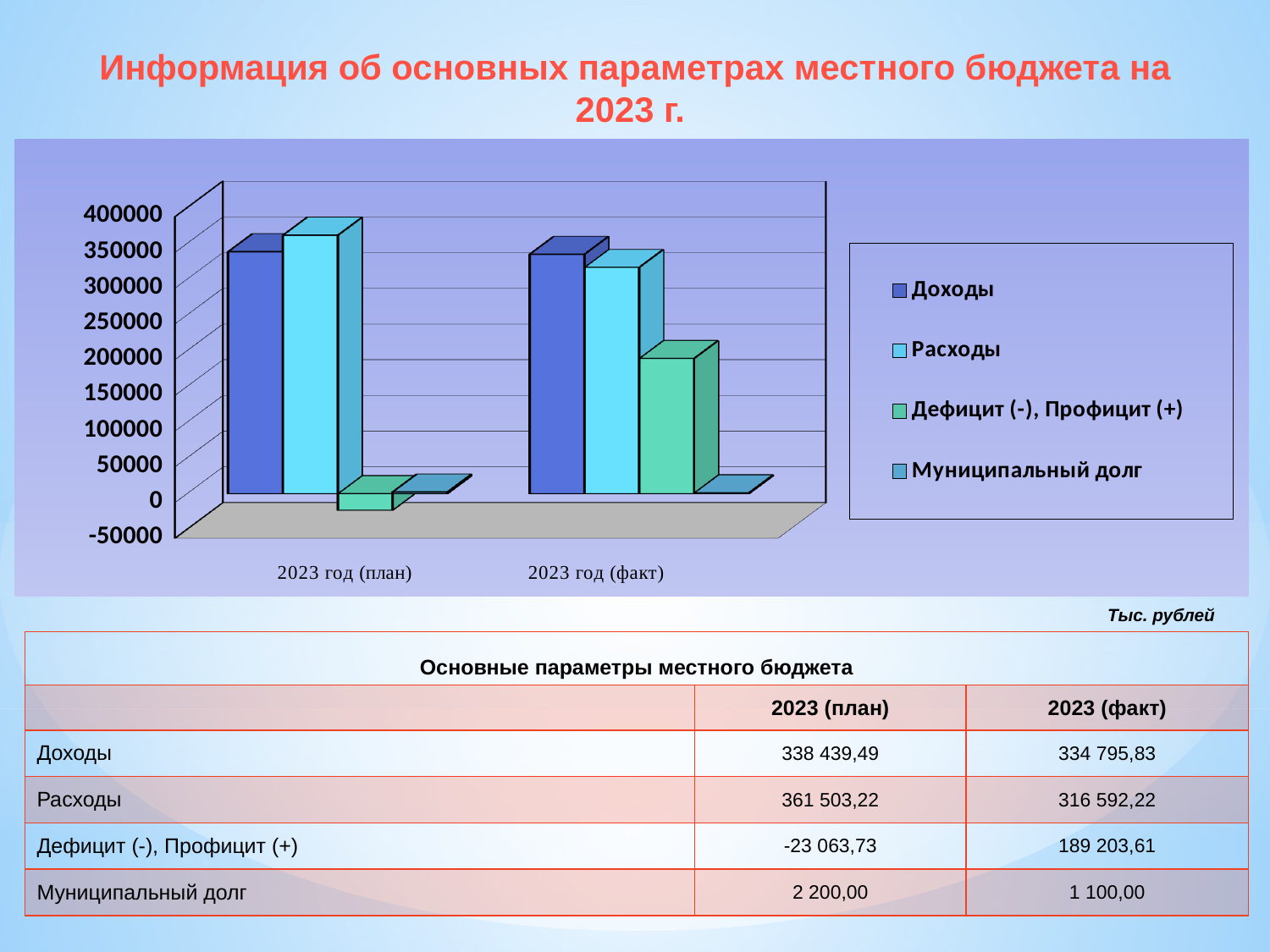
What is the value of Доходы for 2023 (план)? 338 439,49 Is the value for Дефицит (-), Профицит (+) in 2023 год (факт) greater or less than 150000? greater What is the difference between Муниципальный долг for 2023 (план) and 2023 (факт)? 1 100,00 Which series has the lowest value in 2023 год (план)? Дефицит (-), Профицит (+) In 2023 год (план), which is larger: Доходы or Расходы? Расходы What kind of chart is shown on the slide? bar chart Which series has the highest value in 2023 год (факт)? Доходы What is the value of Муниципальный долг for 2023 (план)? 2 200,00 In 2023 год (факт), which is larger: Доходы or Расходы? Доходы How many series does the chart legend list? 4 What is the value of Расходы for 2023 (факт)? 316 592,22 How many categories are shown on the x axis of the chart? 2